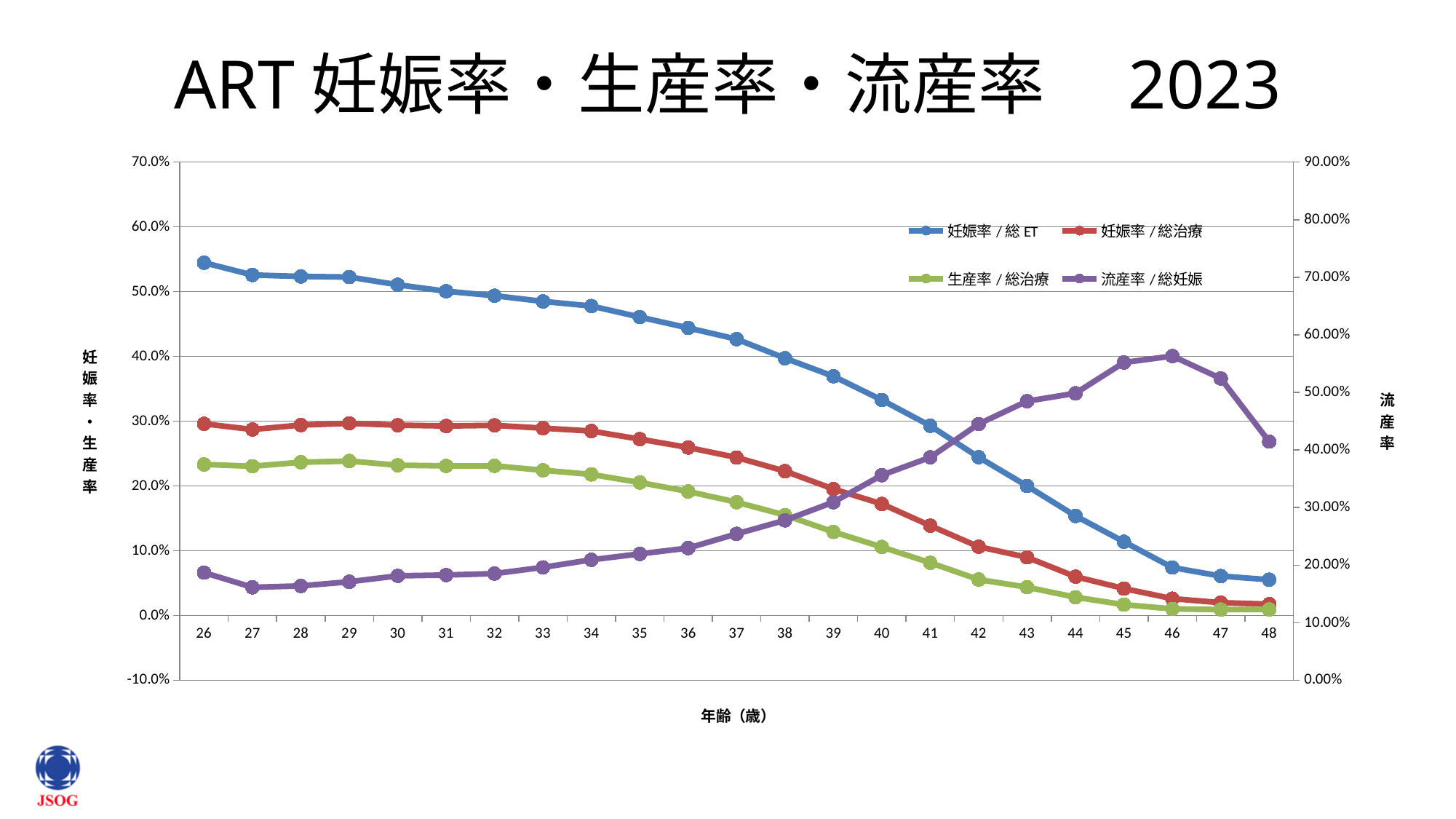
What kind of chart is shown on the slide? line chart At which age is the 妊娠率 / 総 ET series highest? 26 Does the 妊娠率 / 総 ET series rise or fall as age increases from 26 to 48? fall How many age categories are plotted along the x axis? 23 Is the value of 流産率 / 総妊娠 at age 46 greater or less than 50.00% on the right axis? greater How many series does the legend list? 4 Does the 流産率 / 総妊娠 series rise or fall as age increases from 30 to 46? rise At which age is the 妊娠率 / 総 ET series lowest? 48 Is the value of 妊娠率 / 総 ET at age 26 greater or less than 50.0%? greater What is the label of the x axis? 年齢（歳） Is the value of 生産率 / 総治療 at age 26 greater or less than 20.0%? greater At age 35, which is higher, 妊娠率 / 総治療 or 生産率 / 総治療? 妊娠率 / 総治療